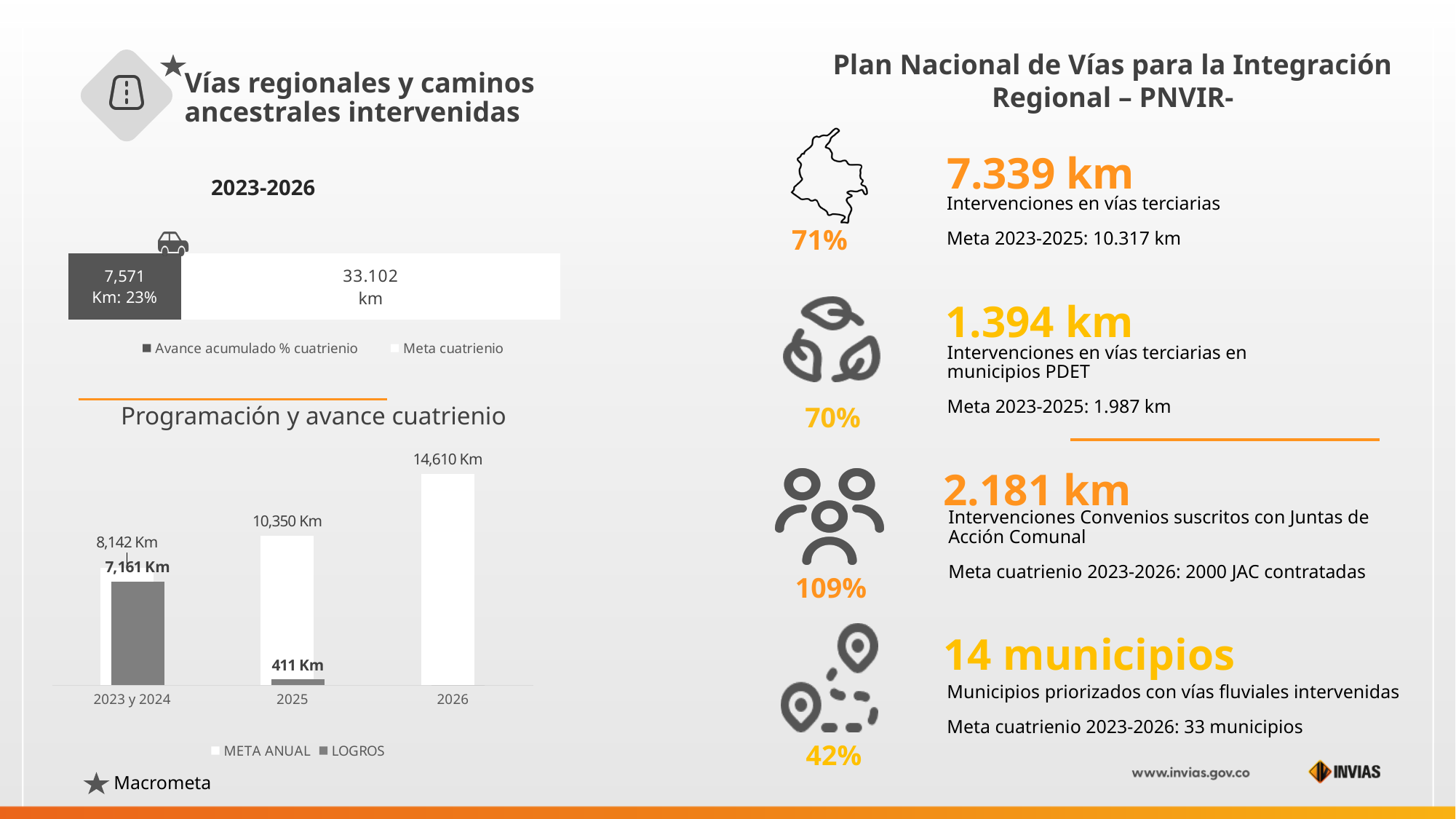
In the 'Programación y avance cuatrienio' chart, how many series does the legend list? 2 In the '2023-2026' chart at the top left, what is the value shown for 'Meta cuatrienio'? 33.102 km In the 'Programación y avance cuatrienio' chart, does the META ANUAL rise or fall from 2023 y 2024 to 2026? rise In the 'Programación y avance cuatrienio' chart, what is the LOGROS value for 2025? 411 Km What kind of chart is 'Programación y avance cuatrienio'? bar chart In the 'Programación y avance cuatrienio' chart, which year has the highest META ANUAL? 2026 In the 'Programación y avance cuatrienio' chart, what is the LOGROS value for 2023 y 2024? 7,161 Km In the 'Programación y avance cuatrienio' chart, how many categories are shown on the x axis? 3 In the 'Programación y avance cuatrienio' chart, what is the META ANUAL value for 2025? 10,350 Km In the 'Programación y avance cuatrienio' chart, which is larger: the LOGROS for 2023 y 2024 or the LOGROS for 2025? 2023 y 2024 In the 'Programación y avance cuatrienio' chart, what is the difference between the META ANUAL and LOGROS for 2023 y 2024? 981 Km In the 'Programación y avance cuatrienio' chart, what is the META ANUAL value for 2026? 14,610 Km